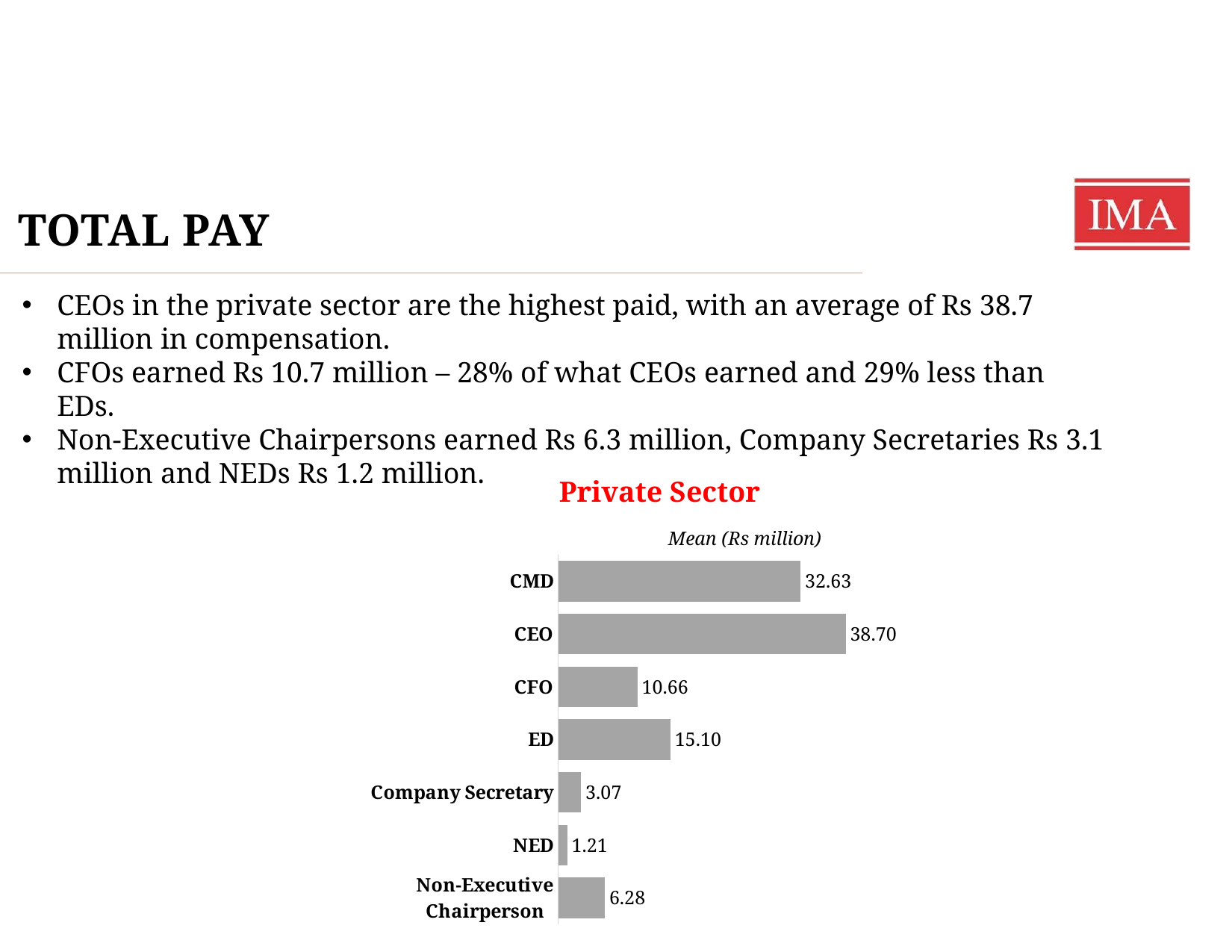
Which has a higher mean total pay in the Private Sector chart, the ED or the CFO? ED What is the difference between the mean total pay of the CEO and the CMD in the Private Sector chart? 6.07 How many roles are shown in the Private Sector chart? 7 What is the difference between the mean total pay of the ED and the CFO in the Private Sector chart? 4.44 What is the mean total pay for the CEO in the Private Sector chart? 38.70 Which role has the highest mean total pay in the Private Sector chart? CEO Which role has the lowest mean total pay in the Private Sector chart? NED What type of chart is used to show the Private Sector mean total pay? Bar chart What is the mean total pay for the CFO in the Private Sector chart? 10.66 What is the mean total pay for the Non-Executive Chairperson in the Private Sector chart? 6.28 What is the mean total pay for the Company Secretary in the Private Sector chart? 3.07 What unit is given in the subtitle of the Private Sector chart? Mean (Rs million)